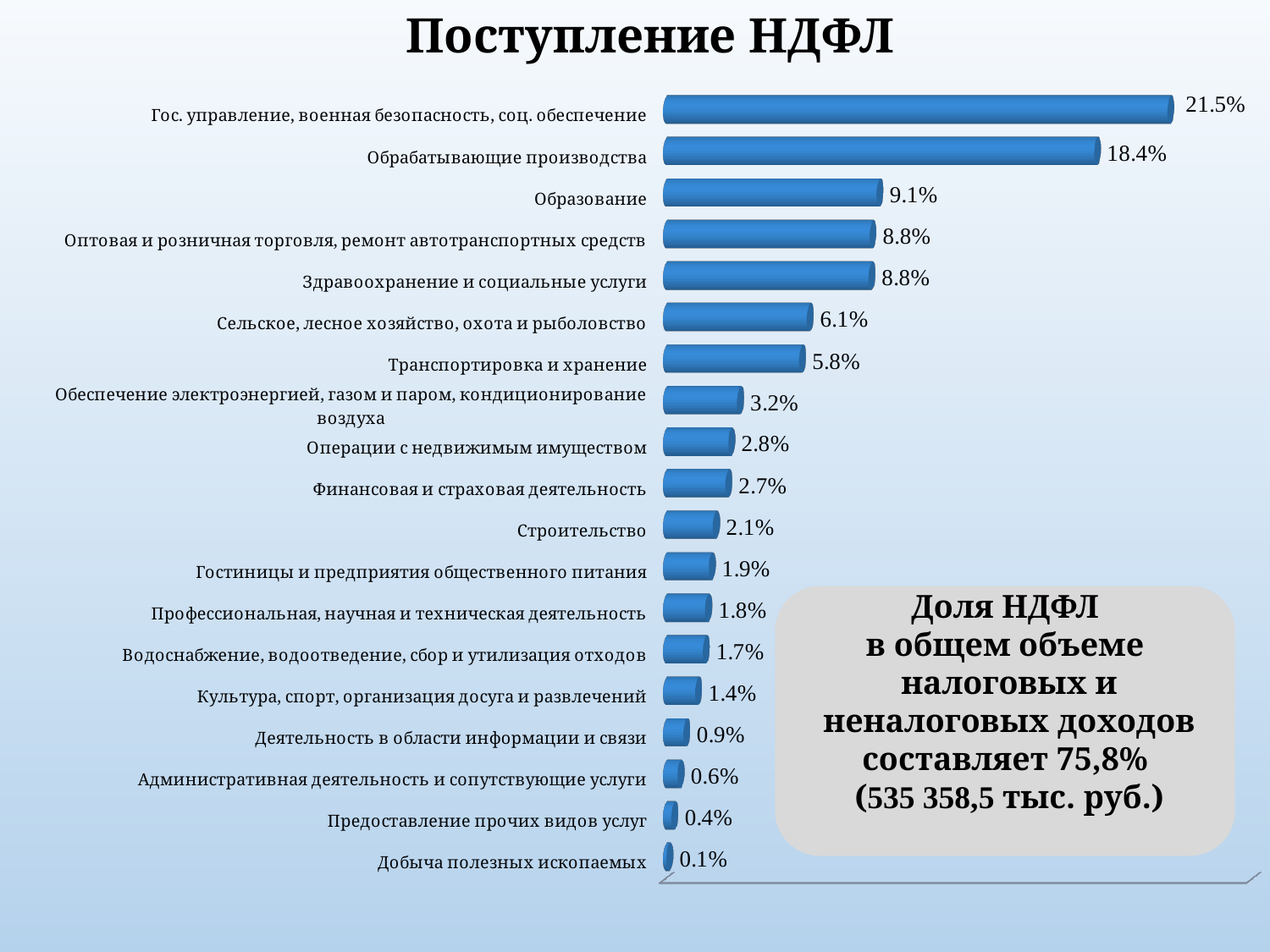
What is the value for Транспортировка и хранение? 5.8% Which category has the lowest value? Добыча полезных ископаемых What is the difference between the values for Образование and Здравоохранение и социальные услуги? 0.3% What type of chart is shown on the slide? Bar chart What is the value for Образование? 9.1% What is the value for Строительство? 2.1% What is the difference between the values for Гос. управление, военная безопасность, соц. обеспечение and Обрабатывающие производства? 3.1% What is the value for Обрабатывающие производства? 18.4% Which category has the highest value? Гос. управление, военная безопасность, соц. обеспечение What is the title of the chart? Поступление НДФЛ How many categories are shown in the chart? 19 Which is larger: the value for Сельское, лесное хозяйство, охота и рыболовство or the value for Обеспечение электроэнергией, газом и паром, кондиционирование воздуха? Сельское, лесное хозяйство, охота и рыболовство